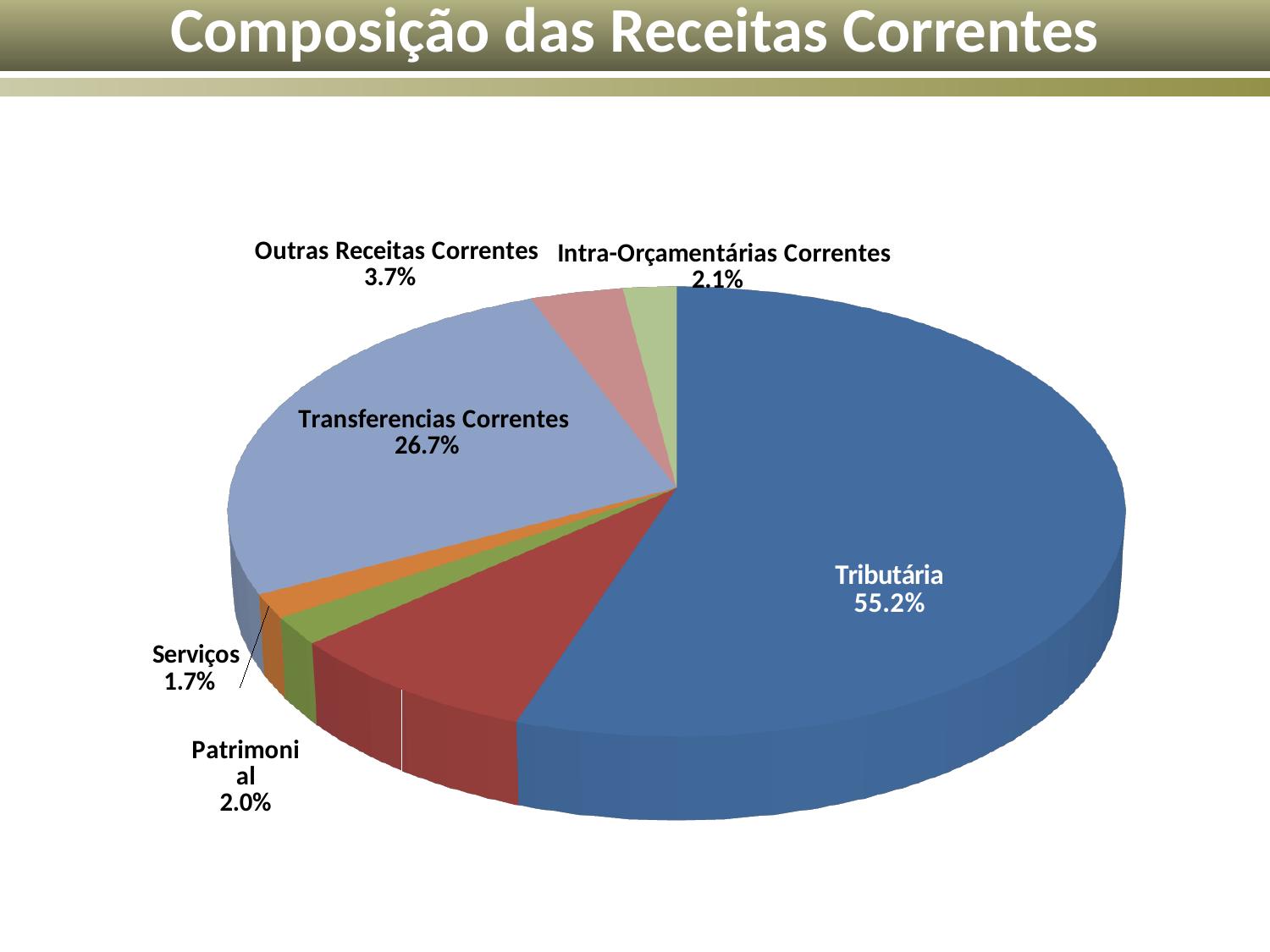
What is the value shown for Outras Receitas Correntes? 3.7% Which category has the largest share of the pie? Tributária What is the value shown for Intra-Orçamentárias Correntes? 2.1% Which is larger, the share for Outras Receitas Correntes or the share for Intra-Orçamentárias Correntes? Outras Receitas Correntes What share of the pie does Tributária represent? 55.2% What is the title of the chart? Composição das Receitas Correntes What is the value shown for Serviços? 1.7% What is the difference between the shares of Tributária and Transferencias Correntes? 28.5% What type of chart is shown on the slide? Pie chart Which labeled category has the smallest share of the pie? Serviços What is the value shown for Patrimonial? 2.0% What is the value shown for Transferencias Correntes? 26.7%